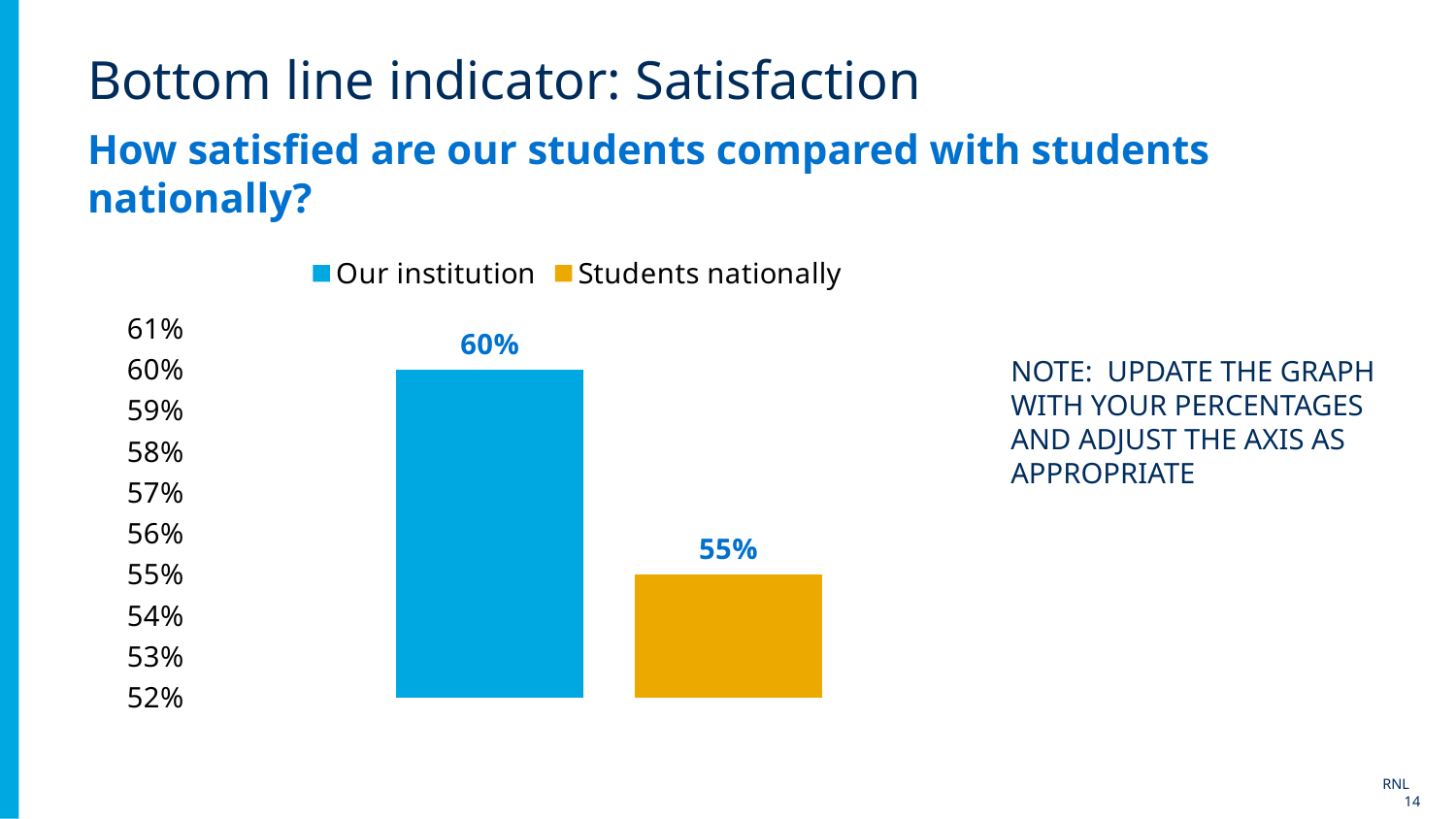
Is the value for Our institution greater or less than 58%? greater Which series has the lowest value? Students nationally What is the value for Our institution? 60% Which series has the higher value, Our institution or Students nationally? Our institution How many series does the legend list? 2 What colour is the bar for Students nationally? Yellow How many bars are plotted in the chart? 2 What kind of chart is shown on the slide? Bar chart What is the lowest value shown on the vertical axis? 52% What is the value for Students nationally? 55% Is the value for Students nationally greater or less than 57%? less What is the difference between the value for Our institution and the value for Students nationally? 5%